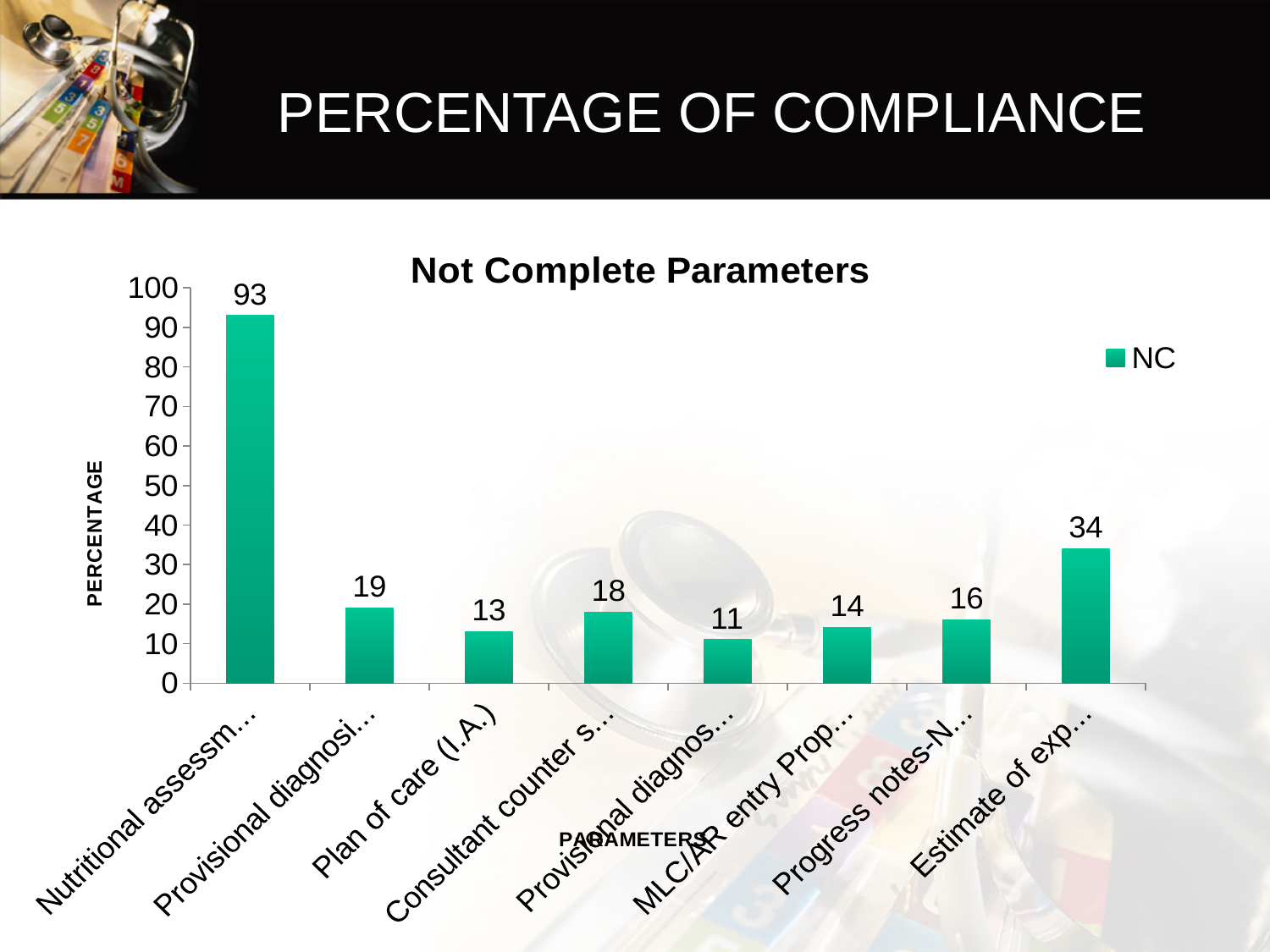
What is the value for the category whose label begins 'Estimate of exp'? 34 What type of chart is shown on the slide? bar chart How many categories are plotted in the chart? 8 What is the value for the category whose label begins 'Progress notes-N'? 16 What is the title of the chart? Not Complete Parameters What is the difference between the value for the category beginning 'Nutritional assessm' and the value for the category beginning 'Estimate of exp'? 59 How many series does the legend list? 1 Which category has the highest value? Nutritional assessm... What is the lowest value shown in the chart? 11 Which is larger, the value for the category beginning 'MLC/AR entry Prop' or the value for the category beginning 'Consultant counter s'? Consultant counter s... What is the value for the category whose label begins 'Nutritional assessm'? 93 What is the value for Plan of care (I.A.)? 13